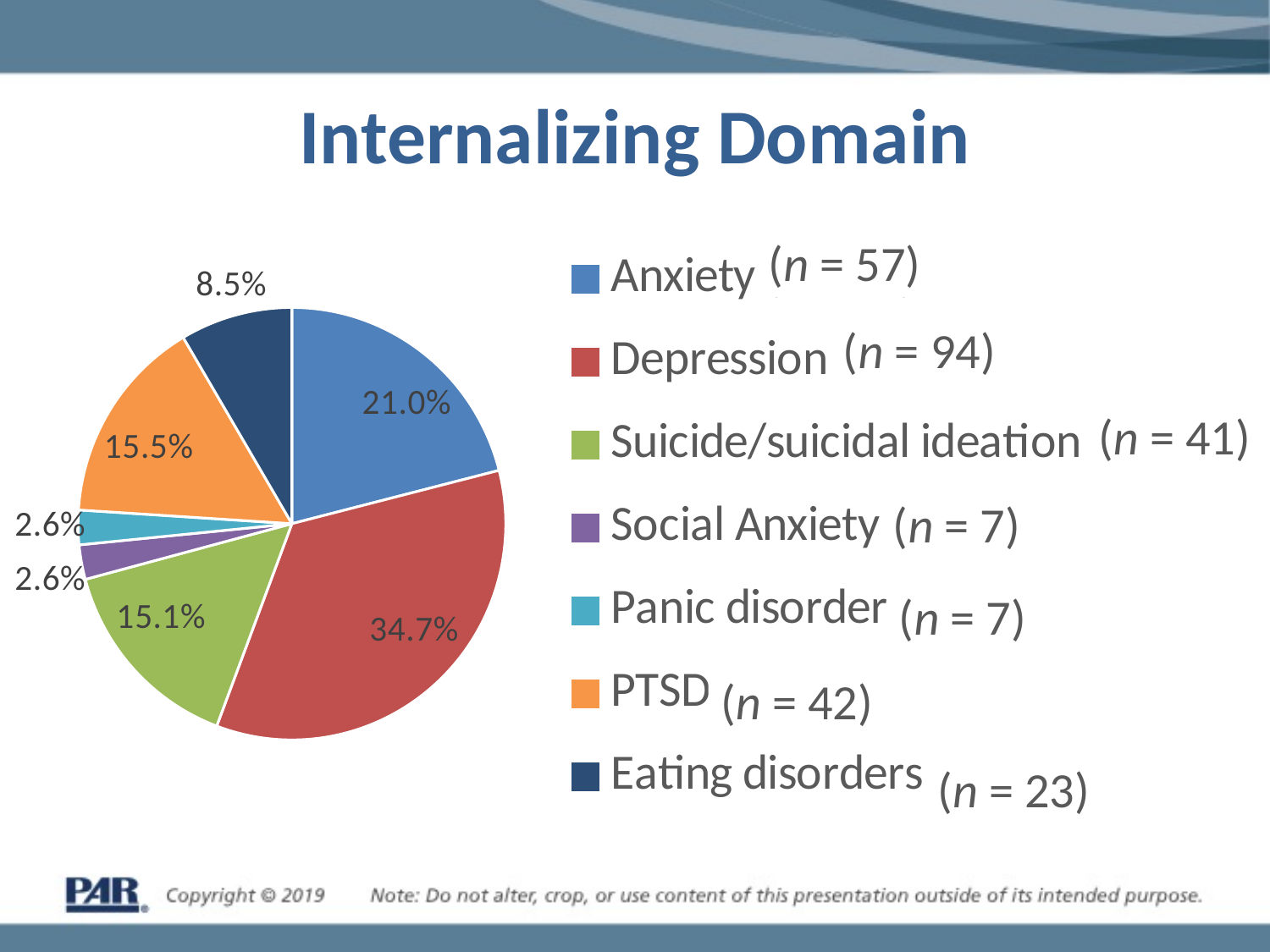
What is the difference in percentage points between Depression and Anxiety? 13.7 How many categories does the legend list? 7 What is the sample size (n) shown in the legend for Depression? 94 What percentage of the pie is Suicide/suicidal ideation? 15.1% Which slice is larger, Anxiety or Eating disorders? Anxiety What percentage of the pie is Anxiety? 21.0% What is the title of the chart? Internalizing Domain What percentage of the pie is Eating disorders? 8.5% Which category has the largest slice of the pie? Depression What percentage of the pie is PTSD? 15.5% What type of chart is shown on the slide? pie chart What percentage of the pie is Depression? 34.7%